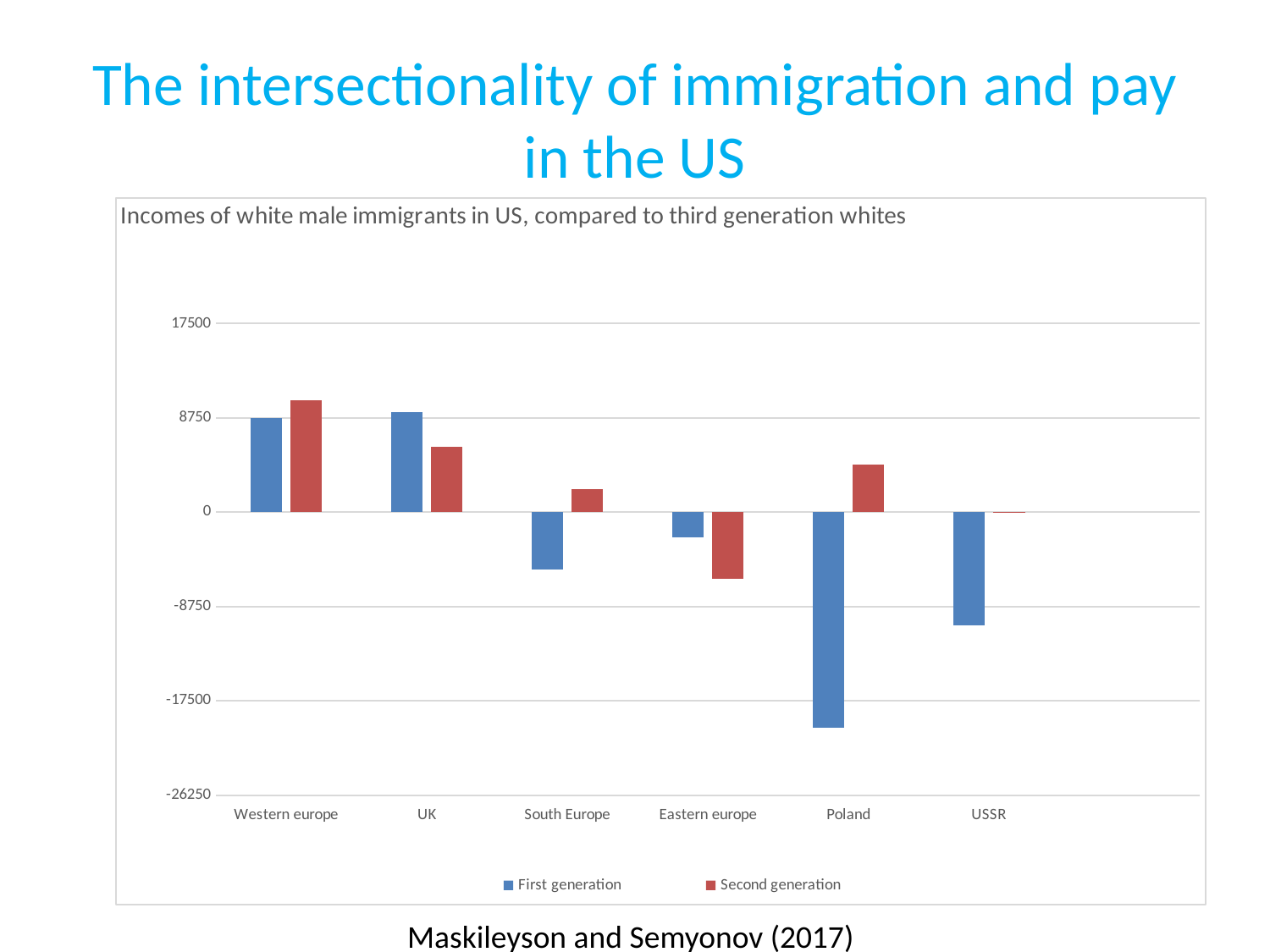
Is the First generation value for USSR greater or less than -8750? less How many series does the legend list? 2 Is the Second generation value for Western europe greater or less than 8750? greater Which category has the highest Second generation value? Western europe What is the title of the chart? Incomes of white male immigrants in US, compared to third generation whites Is the Second generation value for UK greater or less than 8750? less How many origin categories are shown on the x axis? 6 Which category has the lowest First generation value? Poland What kind of chart is shown on the slide? bar chart For the UK, which is larger: the First generation value or the Second generation value? First generation